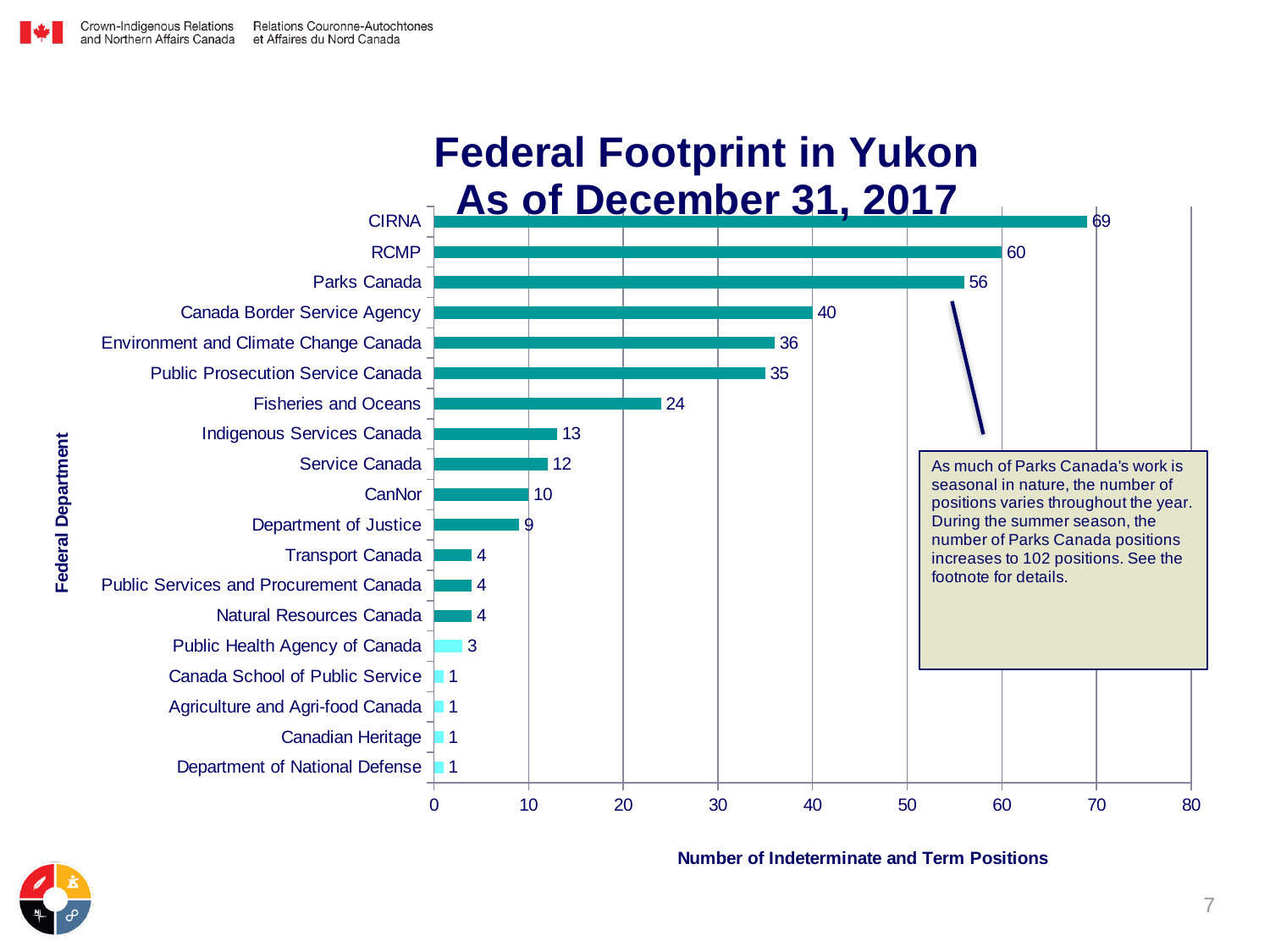
How many positions does CIRNA have in the chart? 69 What is the value for CanNor? 10 Which has a larger value, Environment and Climate Change Canada or Fisheries and Oceans? Environment and Climate Change Canada What is the difference between the values for Canada Border Service Agency and Public Prosecution Service Canada? 5 What type of chart is shown on the slide? bar chart What is the label of the horizontal axis? Number of Indeterminate and Term Positions How many federal departments are listed in the chart? 19 What is the value for Fisheries and Oceans? 24 Which federal department has the highest number of positions? CIRNA What is the value for Parks Canada? 56 What is the difference between the values for RCMP and Parks Canada? 4 What is the title of the chart? Federal Footprint in Yukon As of December 31, 2017